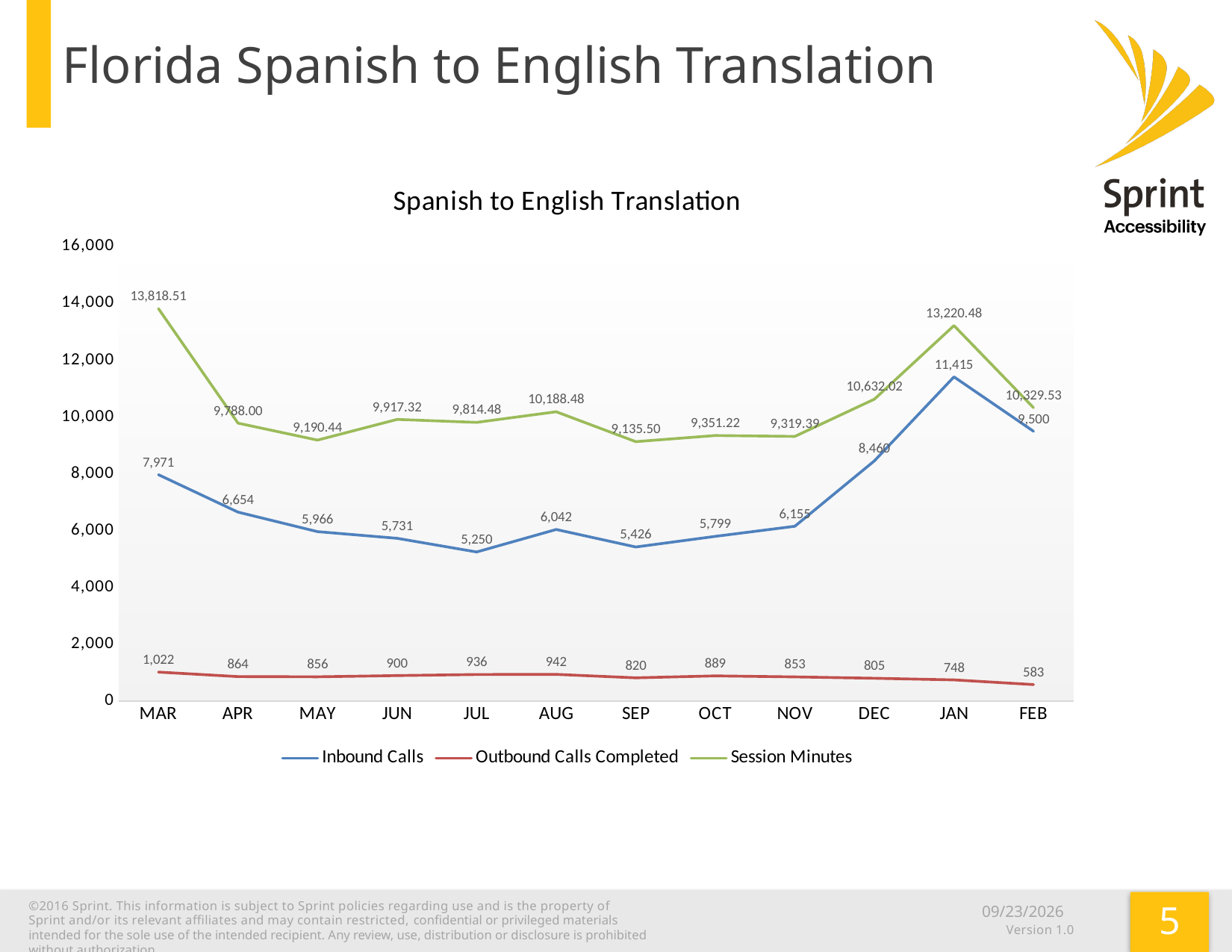
How many series does the legend list? 3 What is the value of Session Minutes in MAR? 13,818.51 What kind of chart is shown on the slide? line chart What is the difference between Inbound Calls in JAN and in DEC? 2,955 Which month has more Outbound Calls Completed, MAR or APR? MAR What is the value of Outbound Calls Completed in FEB? 583 In which month are Outbound Calls Completed lowest? FEB How many months are shown on the x axis? 12 Is the value for Session Minutes in AUG greater or less than 10,000? greater In which month are Inbound Calls lowest? JUL In which month are Session Minutes highest? MAR What is the value of Inbound Calls in JAN? 11,415